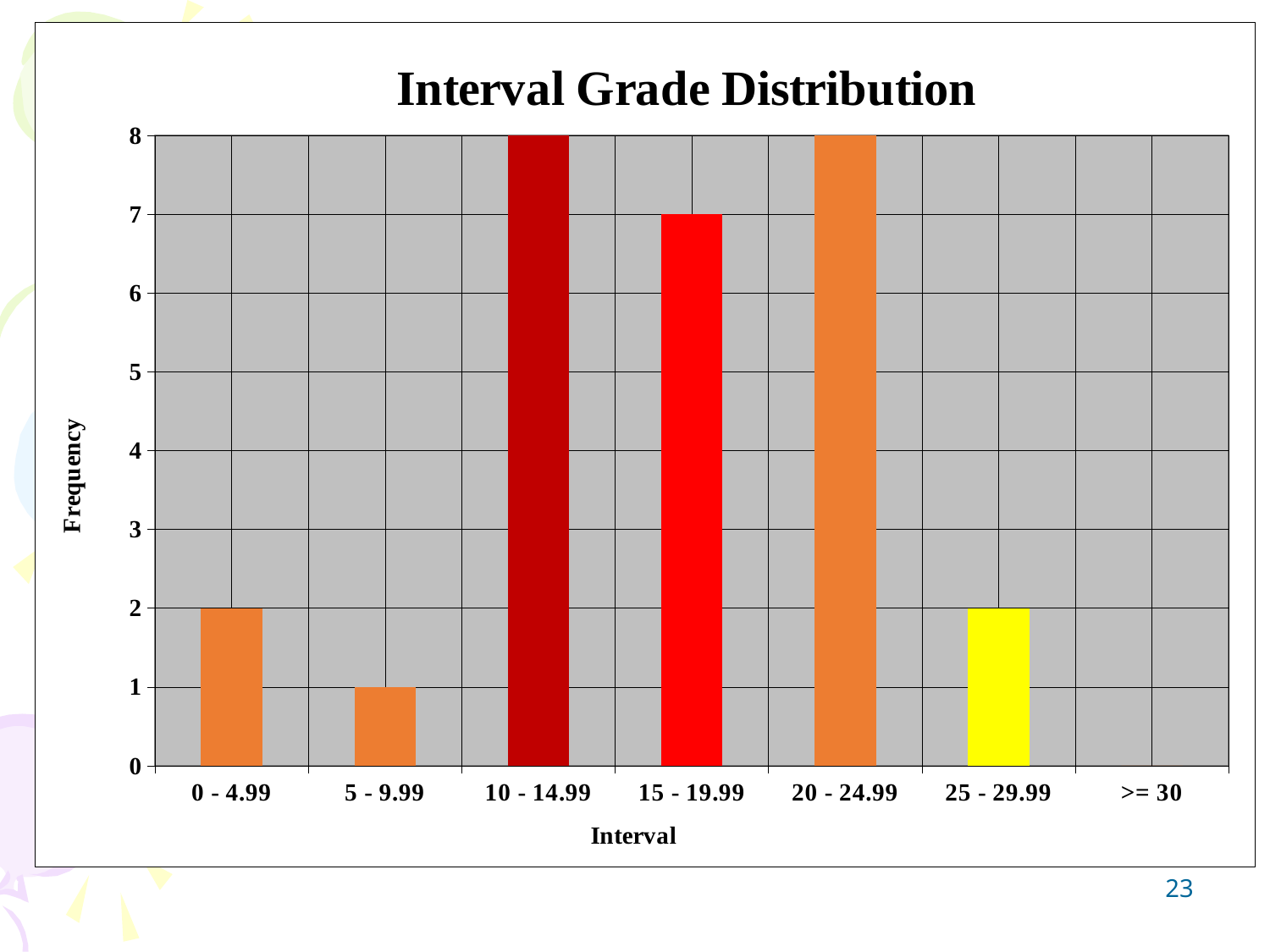
Is the frequency for the 15 - 19.99 interval greater or less than 5? greater What is the frequency for the interval 10 - 14.99? 8 What is the label of the y axis? Frequency What type of chart is shown on the slide? bar chart What is the frequency for the interval 25 - 29.99? 2 What is the difference in frequency between the 20 - 24.99 interval and the 0 - 4.99 interval? 6 Which interval has the lowest frequency? >= 30 Which has a higher frequency, the 15 - 19.99 interval or the 25 - 29.99 interval? 15 - 19.99 How many intervals are shown on the x axis? 7 What is the frequency for the interval 15 - 19.99? 7 What is the title of the chart? Interval Grade Distribution What is the frequency for the interval 5 - 9.99? 1